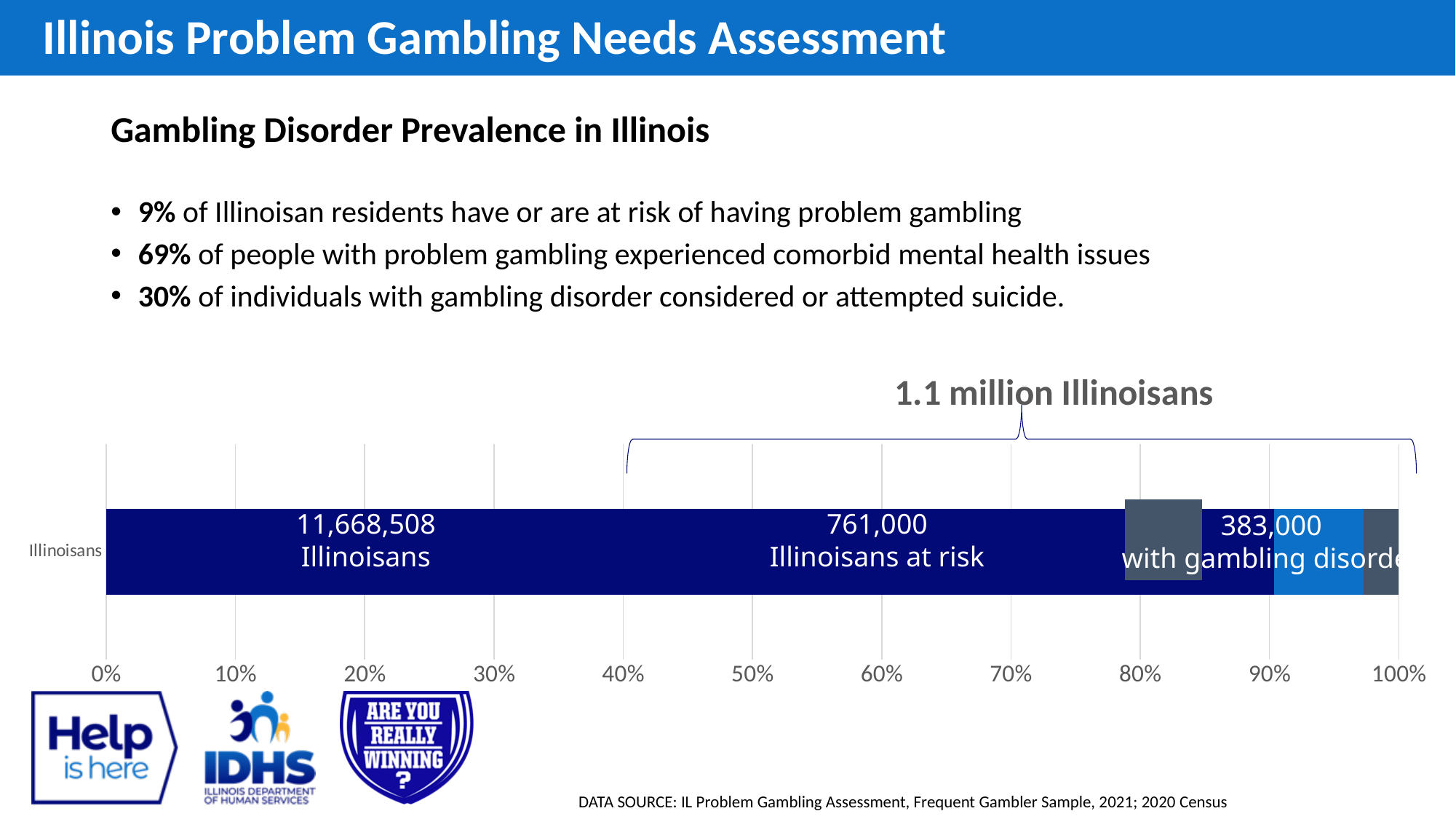
What text appears above the bracket spanning the right part of the chart? 1.1 million Illinoisans What kind of chart is shown on the slide? Stacked bar chart How many Illinoisans are labelled as being at risk in the chart? 761,000 Which labelled group in the bar has the smallest value? With gambling disorder (383,000) How many Illinoisans are labelled as having a gambling disorder in the chart? 383,000 What is the total of the three labelled values in the stacked bar? 12,812,508 How many Illinoisans does the largest segment of the bar represent? 11,668,508 Which is larger: the number of Illinoisans at risk or the number with gambling disorder? Illinoisans at risk What is the difference between the number of Illinoisans at risk and the number with gambling disorder? 378,000 Is the share of the bar taken by the 11,668,508 Illinoisans segment greater or less than 80%? greater How many category labels appear on the vertical axis of the chart? 1 Which labelled group in the bar has the largest value? Illinoisans (11,668,508)